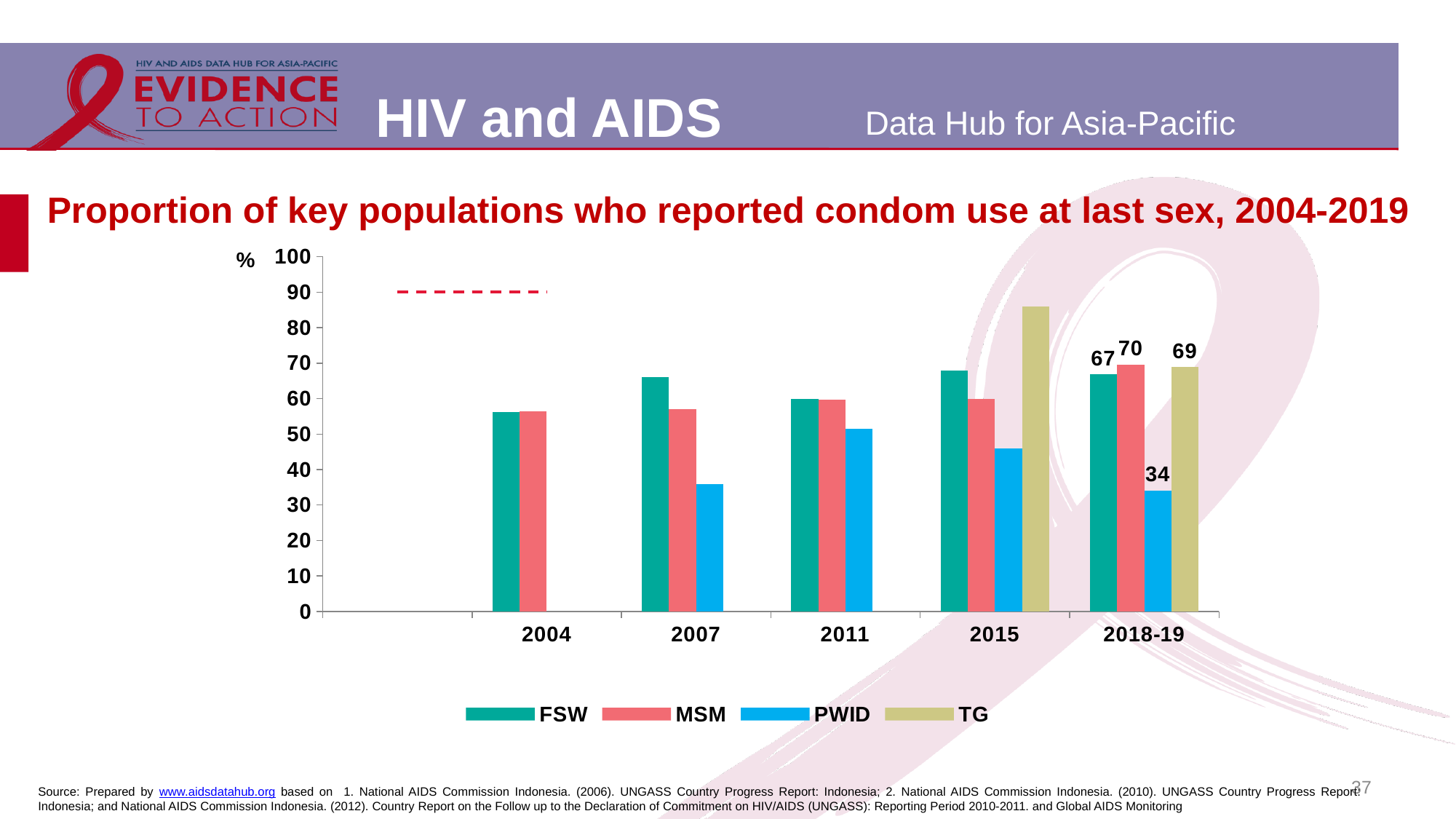
Is the value for PWID in 2007 greater or less than 40? less What is the value for MSM in 2018-19? 70 Which key population has the lowest value in 2018-19? PWID How many time periods are shown on the x axis? 5 What kind of chart is shown on the slide? Bar chart What is the value for FSW in 2018-19? 67 What is the value for PWID in 2018-19? 34 In 2011, which is larger, the value for FSW or the value for PWID? FSW Is the value for TG in 2015 greater or less than 80? greater What is the value for TG in 2018-19? 69 What is the difference between the MSM and PWID values in 2018-19? 36 How many series does the legend list? 4